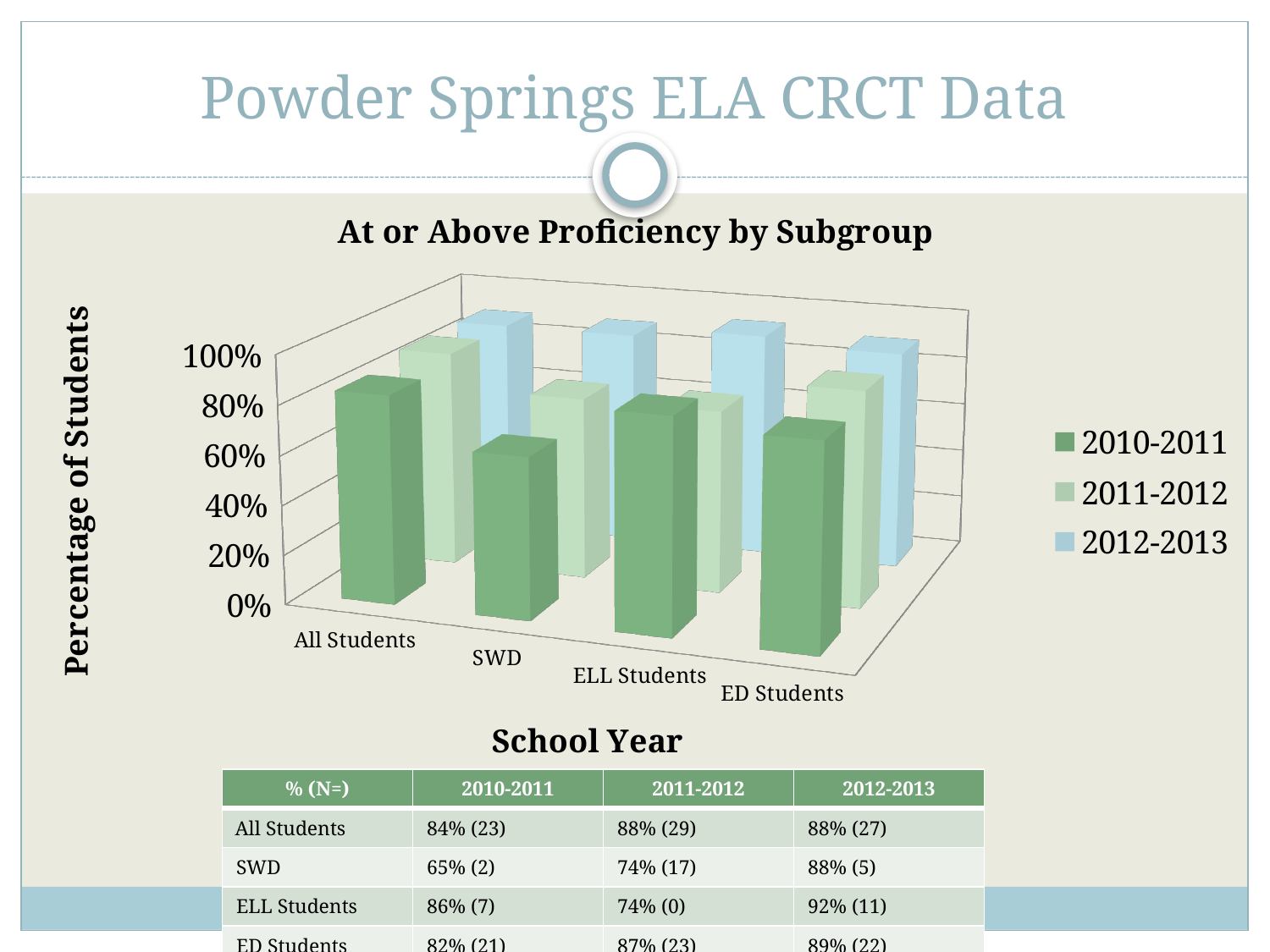
What kind of chart is shown on the slide? bar chart What is the difference between the SWD values for 2012-2013 and 2010-2011? 23% What is the percentage of ELL Students at or above proficiency in 2012-2013? 92% How many series does the legend list? 3 Is the 2010-2011 value for SWD greater or less than 80%? less Which subgroup has the lowest value for 2010-2011? SWD Which subgroup has the highest value for 2012-2013? ELL Students What is the title of the chart? At or Above Proficiency by Subgroup Which is larger for ELL Students: the 2010-2011 value or the 2011-2012 value? 2010-2011 How many subgroup categories are plotted along the x axis? 4 What is the percentage of SWD students at or above proficiency in 2010-2011? 65% What is the percentage of All Students at or above proficiency in 2011-2012? 88%